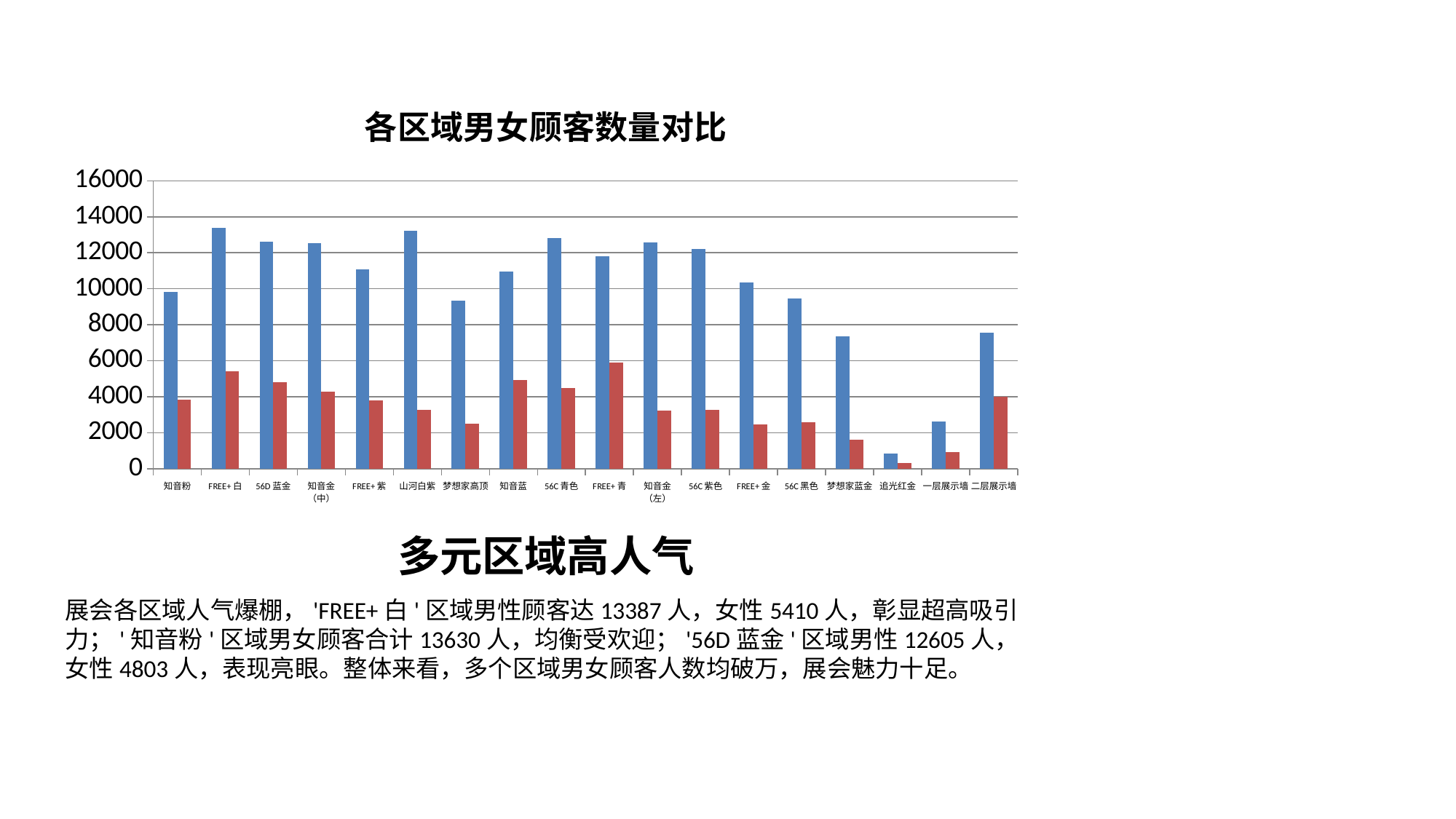
How many regions (categories) are shown on the x axis of the chart? 18 Which region has the lowest number of male customers (blue bars)? 追光红金 Is the male customer value (blue bar) for '梦想家蓝金' greater or less than 8000? less Which region has more male customers, 'FREE+ 白' or '56D 蓝金'? FREE+ 白 What is the number of male customers for the 'FREE+ 白' region? 13387 What is the difference between male and female customers in the 'FREE+ 白' region? 7977 Which region has the highest number of female customers (red bars)? FREE+ 青 What is the number of female customers for the 'FREE+ 白' region? 5410 What is the number of male customers for the '56D 蓝金' region? 12605 What type of chart is shown on the slide? Bar chart What is the title of the chart? 各区域男女顾客数量对比 What is the difference between male and female customers in the '56D 蓝金' region? 7802